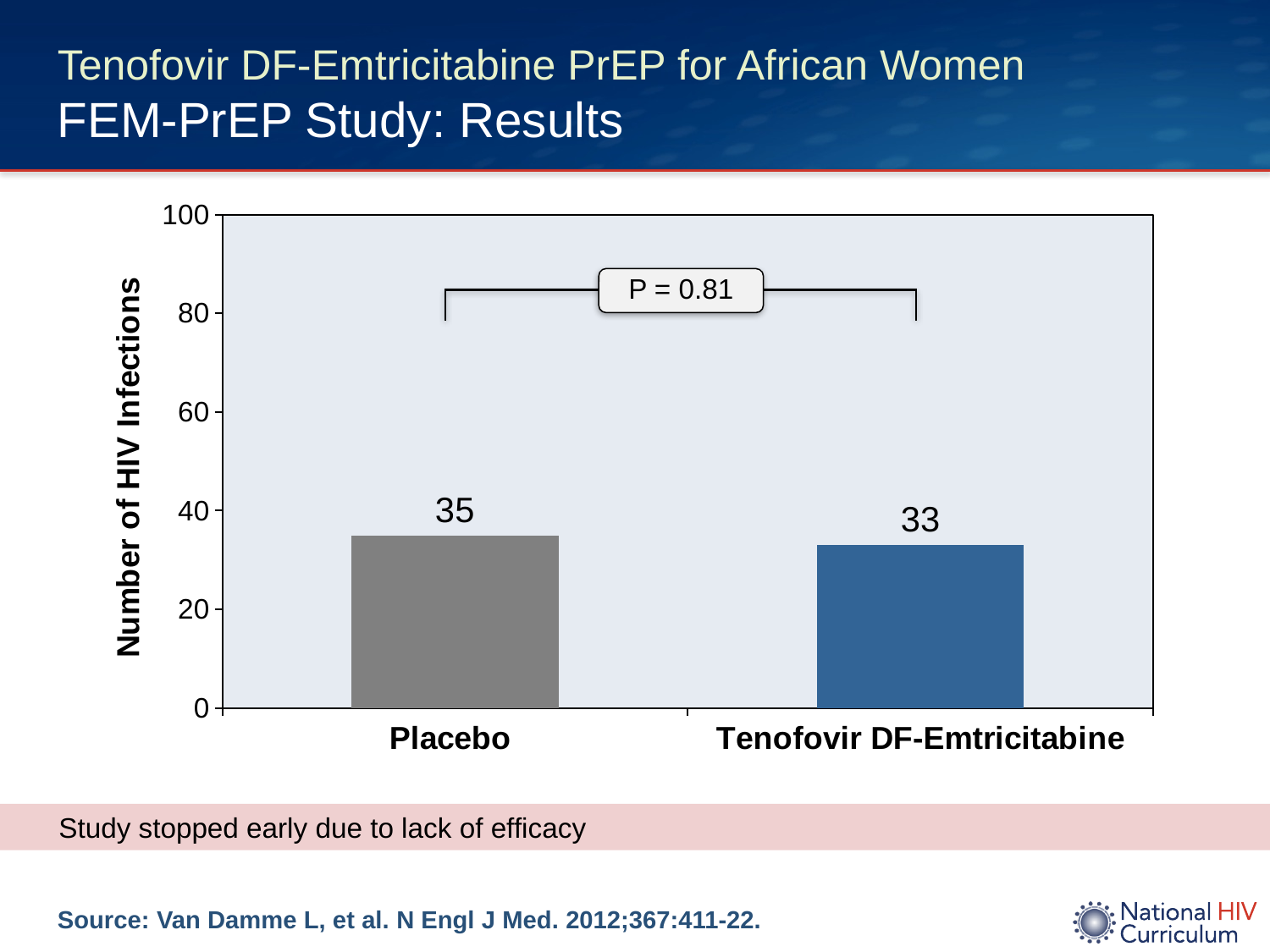
What is the number of HIV infections for the Placebo group? 35 Which group has the lower number of HIV infections? Tenofovir DF-Emtricitabine Which group has the higher number of HIV infections? Placebo What is the difference in the number of HIV infections between the Placebo and Tenofovir DF-Emtricitabine groups? 2 What is the total number of HIV infections across both groups? 68 Is the number of HIV infections for Tenofovir DF-Emtricitabine greater or less than 20? greater Is the number of HIV infections for Placebo greater or less than 40? less What is the P value shown on the chart comparing the two groups? P = 0.81 What is the label of the y-axis? Number of HIV Infections How many groups are shown on the chart? 2 What is the number of HIV infections for the Tenofovir DF-Emtricitabine group? 33 What kind of chart is shown on the slide? Bar chart